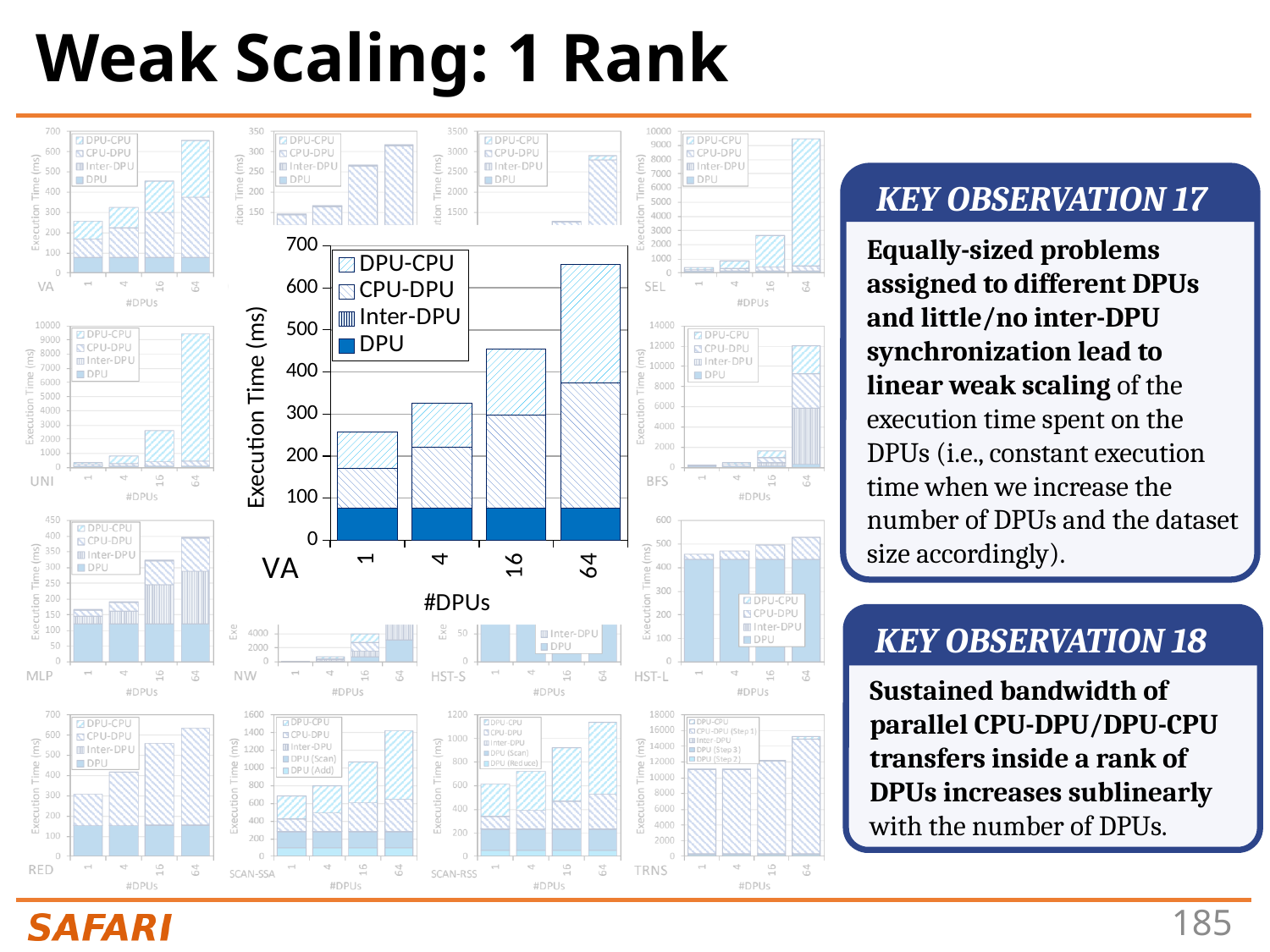
On the enlarged VA chart in the center of the slide, what kind of chart is shown? stacked bar chart On the enlarged VA chart, is the DPU portion of the bar for 4 DPUs greater or less than 100? less On the enlarged VA chart, which total bar is taller: 4 DPUs or 16 DPUs? 16 DPUs On the enlarged VA chart, does the total execution time rise or fall as #DPUs increases from 1 to 64? rise On the enlarged VA chart, is the total execution time for 64 DPUs greater or less than 600? greater On the enlarged VA chart, is the total execution time for 16 DPUs greater or less than 400? greater On the enlarged VA chart, how many series does the legend list? 4 On the enlarged VA chart, which #DPUs value has the tallest total bar? 64 On the enlarged VA chart, how many #DPUs categories are shown on the x axis? 4 On the enlarged VA chart, what is the label of the y axis? Execution Time (ms) On the enlarged VA chart, which #DPUs value has the shortest total bar? 1